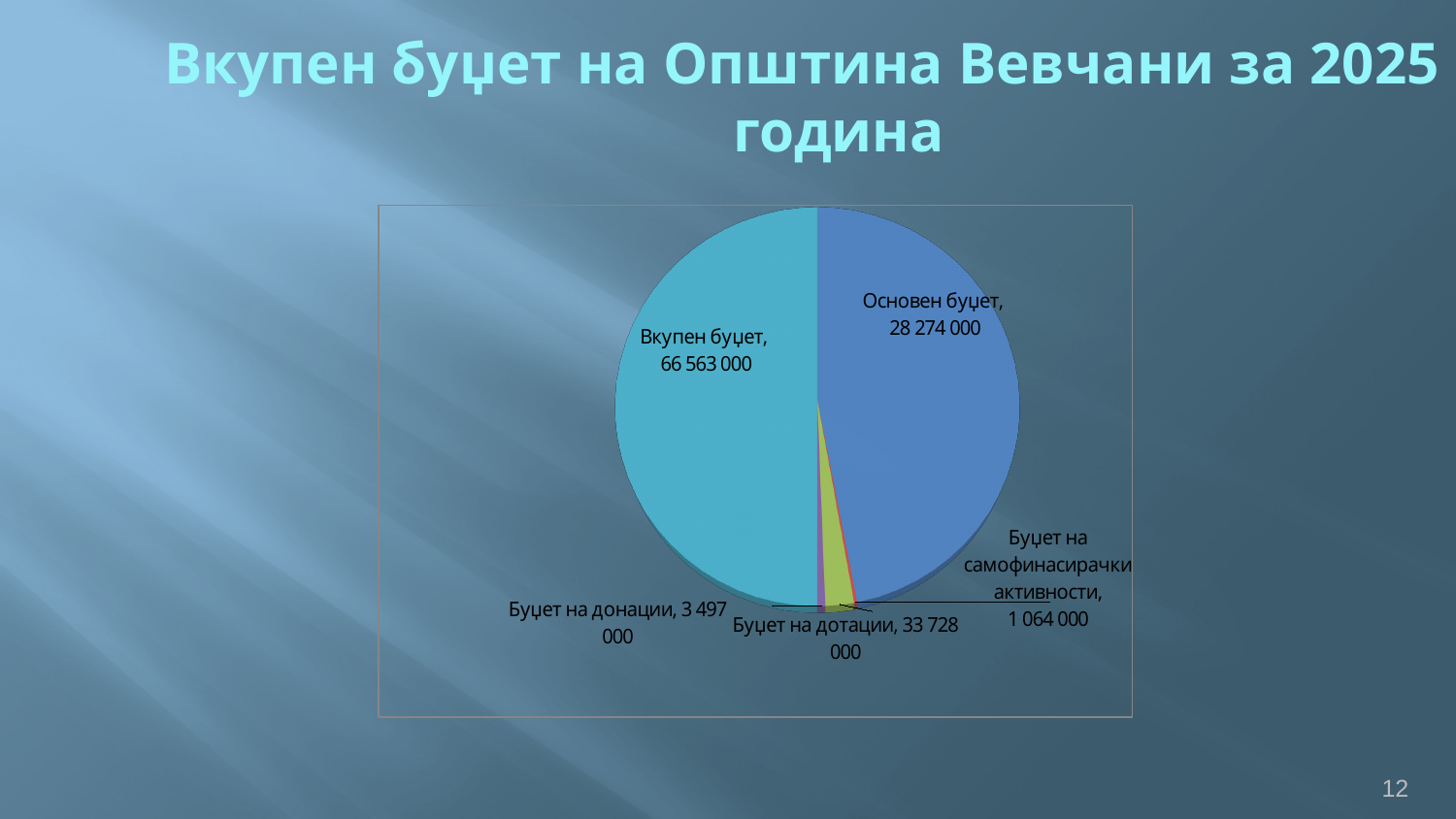
What is the value shown for Буџет на дотации? 33 728 000 What kind of chart is shown on the slide? pie chart What is the value shown for Буџет на самофинасирачки активности? 1 064 000 Which is larger, Буџет на донации or Буџет на самофинасирачки активности? Буџет на донации What is the value shown for Буџет на донации? 3 497 000 Which slice has the largest value? Вкупен буџет What is the title of the slide containing the chart? Вкупен буџет на Општина Вевчани за 2025 година What is the difference between Буџет на дотации and Основен буџет? 5 454 000 How many slices does the pie chart have? 5 What is the value shown for Основен буџет? 28 274 000 Which slice has the smallest value? Буџет на самофинасирачки активности What is the value shown for Вкупен буџет? 66 563 000